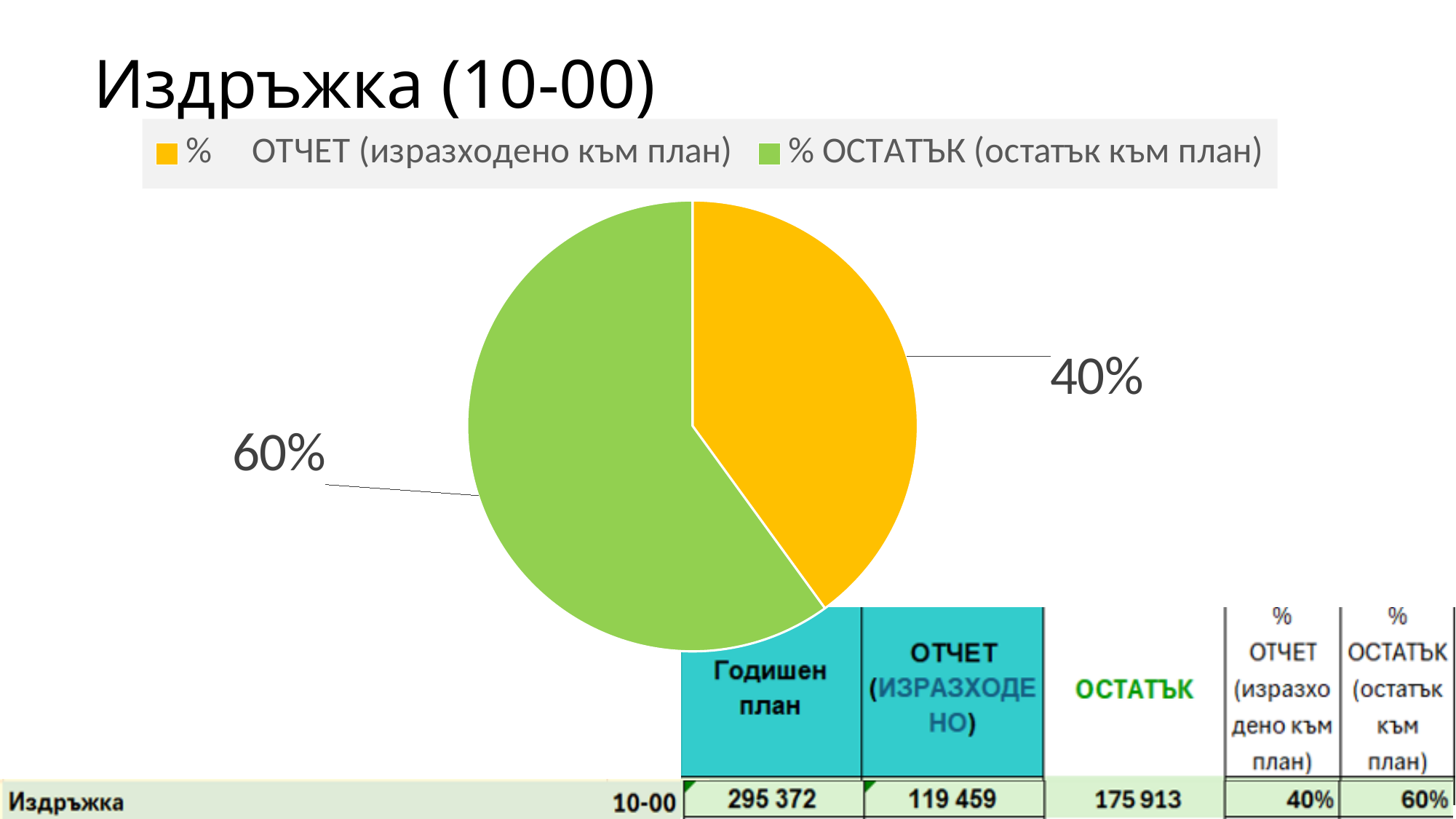
How many slices does the pie chart have? 2 Which slice is the largest in the pie chart? % ОСТАТЪК (остатък към план) What share of the pie does the "% ОСТАТЪК (остатък към план)" slice represent? 60% What is the difference in percentage points between the "% ОСТАТЪК" slice and the "% ОТЧЕТ" slice? 20 percentage points Is the share of the "% ОТЧЕТ" slice greater or less than 50%? less What colour is the "% ОСТАТЪК (остатък към план)" slice? green What colour is the "% ОТЧЕТ (изразходено към план)" slice? yellow/orange What type of chart is shown on the slide? pie chart Which slice is the smallest in the pie chart? % ОТЧЕТ (изразходено към план) What share of the pie does the "% ОТЧЕТ (изразходено към план)" slice represent? 40% How many entries does the legend list? 2 Which is larger: the "% ОТЧЕТ" slice or the "% ОСТАТЪК" slice? % ОСТАТЪК